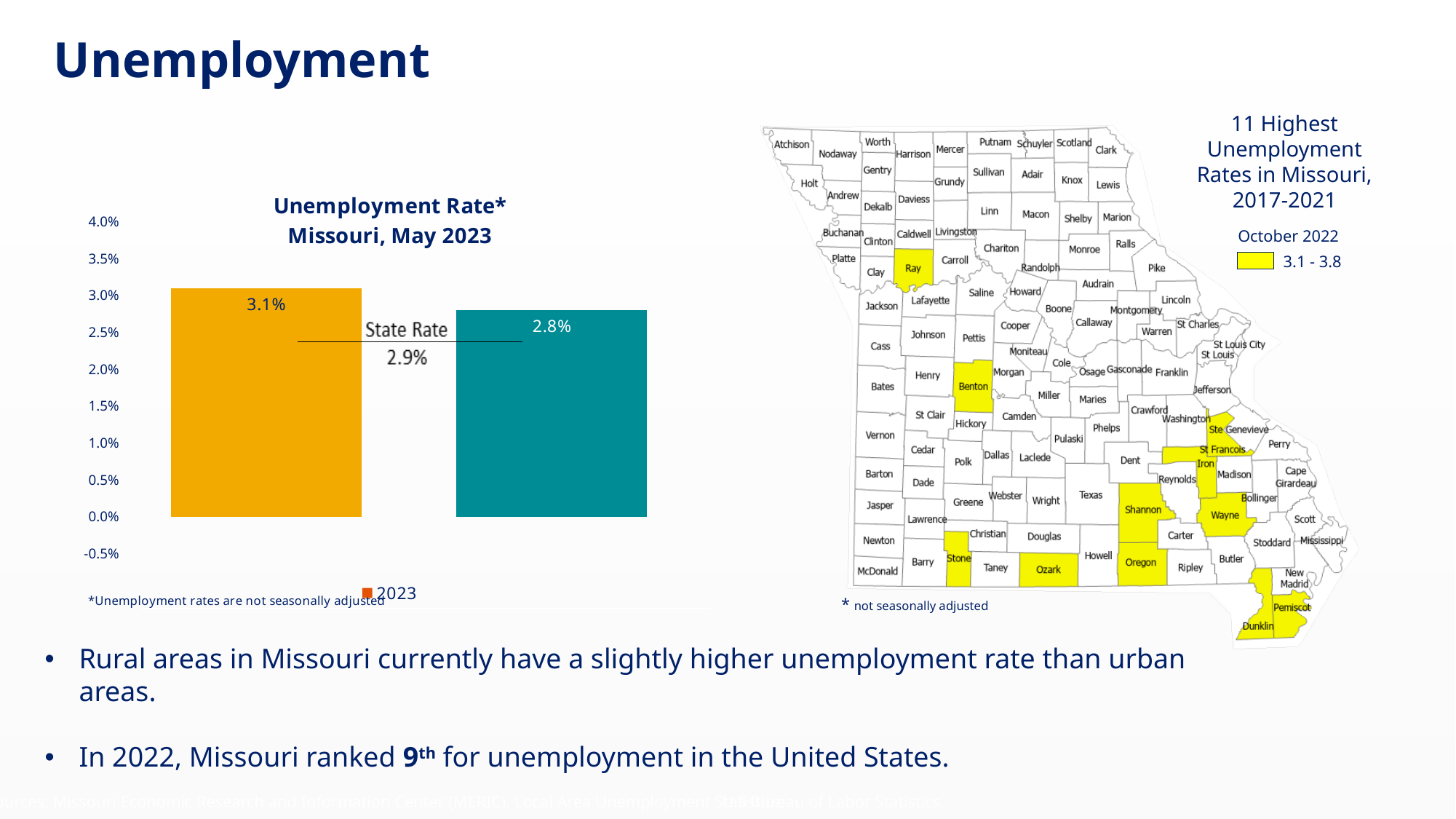
In the 'Unemployment Rate* Missouri, May 2023' chart, what is the State Rate shown by the horizontal line? 2.9% In the 'Unemployment Rate* Missouri, May 2023' chart, which bar is the highest? The left (orange) bar In the 'Unemployment Rate* Missouri, May 2023' chart, which bar is the lowest? The right (teal) bar What kind of chart is the 'Unemployment Rate* Missouri, May 2023' chart? Bar chart In the 'Unemployment Rate* Missouri, May 2023' chart, what value is shown on the left (orange) bar? 3.1% How many series does the legend of the 'Unemployment Rate* Missouri, May 2023' chart list? 1 In the 'Unemployment Rate* Missouri, May 2023' chart, what value is shown on the right (teal) bar? 2.8% In the 'Unemployment Rate* Missouri, May 2023' chart, is the right (teal) bar greater or less than 3.0%? less In the 'Unemployment Rate* Missouri, May 2023' chart, what is the difference between the left bar (3.1%) and the right bar (2.8%)? 0.3% In the 'Unemployment Rate* Missouri, May 2023' chart, is the left (orange) bar greater or less than 3.0%? greater How many bars are plotted in the 'Unemployment Rate* Missouri, May 2023' chart? 2 What is the legend entry shown below the 'Unemployment Rate* Missouri, May 2023' chart? 2023